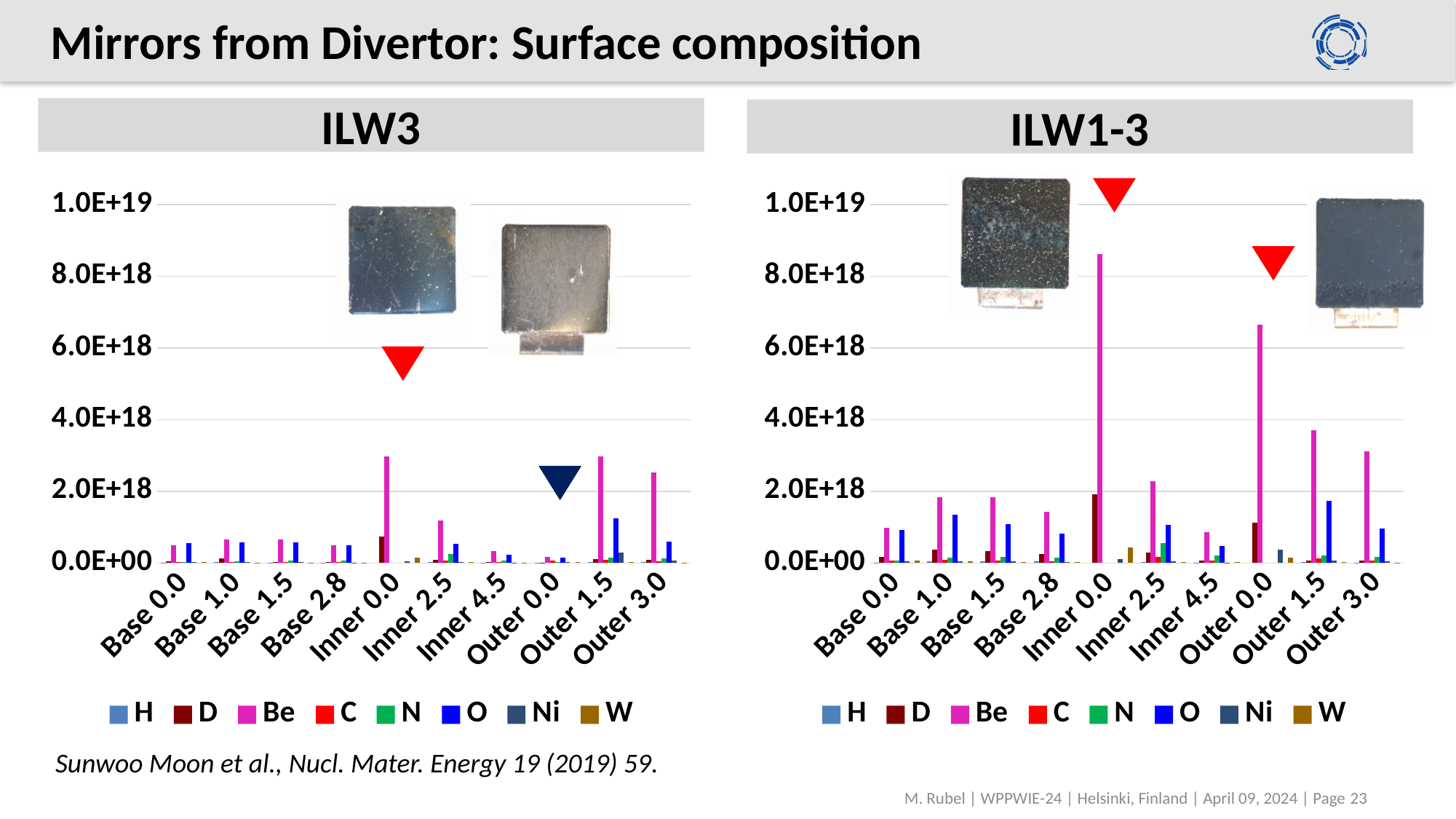
In the ILW1-3 chart, is the Be value for Inner 0.0 greater or less than 8.0E+18? greater What is the highest tick value shown on the y axis of the ILW1-3 chart? 1.0E+19 Which series in the ILW3 chart legend is shown in pink/magenta? Be In the ILW1-3 chart, which category has the highest Be value? Inner 0.0 How many series does the legend of the ILW1-3 chart list? 8 How many categories are shown on the x axis of the ILW3 chart? 10 In the ILW3 chart, is the Be value for Outer 3.0 greater or less than 2.0E+18? greater In the ILW3 chart, is the Be value for Inner 2.5 greater or less than 2.0E+18? less What kind of chart is the ILW3 chart? bar chart In the ILW1-3 chart, which is larger: the Be value for Inner 0.0 or the Be value for Outer 0.0? Inner 0.0 In the ILW3 chart, which is larger: the Be value for Inner 2.5 or the Be value for Outer 3.0? Outer 3.0